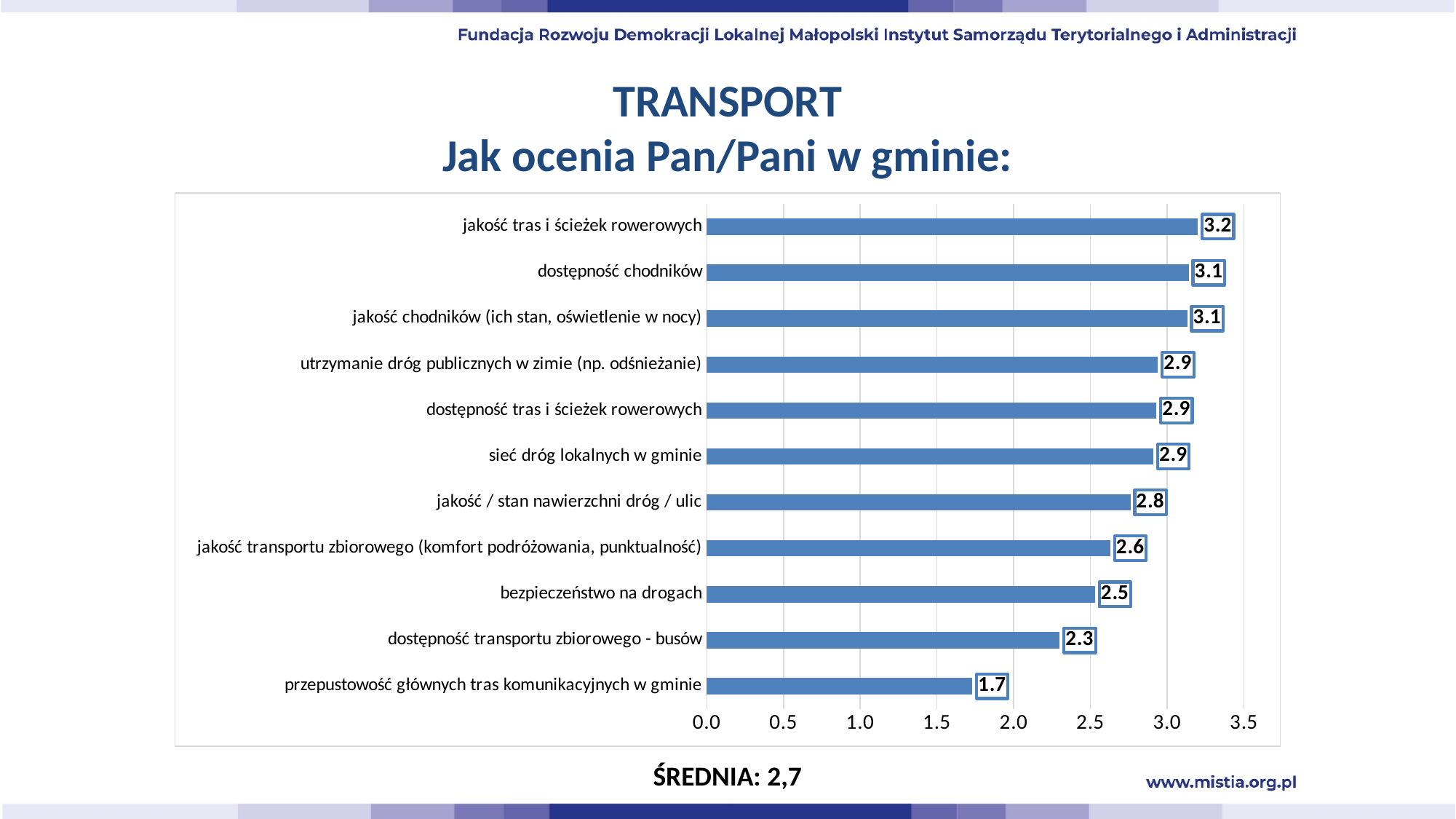
What average (ŚREDNIA) is stated below the chart? 2,7 Is the value for "dostępność chodników" greater or less than 3.0? greater What is the value for "dostępność transportu zbiorowego - busów"? 2.3 What is the value for "przepustowość głównych tras komunikacyjnych w gminie"? 1.7 Which category has the highest value? jakość tras i ścieżek rowerowych Which is larger: the value for "jakość / stan nawierzchni dróg / ulic" or the value for "bezpieczeństwo na drogach"? jakość / stan nawierzchni dróg / ulic How many categories are shown in the chart? 11 Which category has the lowest value? przepustowość głównych tras komunikacyjnych w gminie What kind of chart is shown on the slide? bar chart What is the difference between the values for "jakość tras i ścieżek rowerowych" and "przepustowość głównych tras komunikacyjnych w gminie"? 1.5 What is the value for "jakość tras i ścieżek rowerowych"? 3.2 What is the value for "bezpieczeństwo na drogach"? 2.5